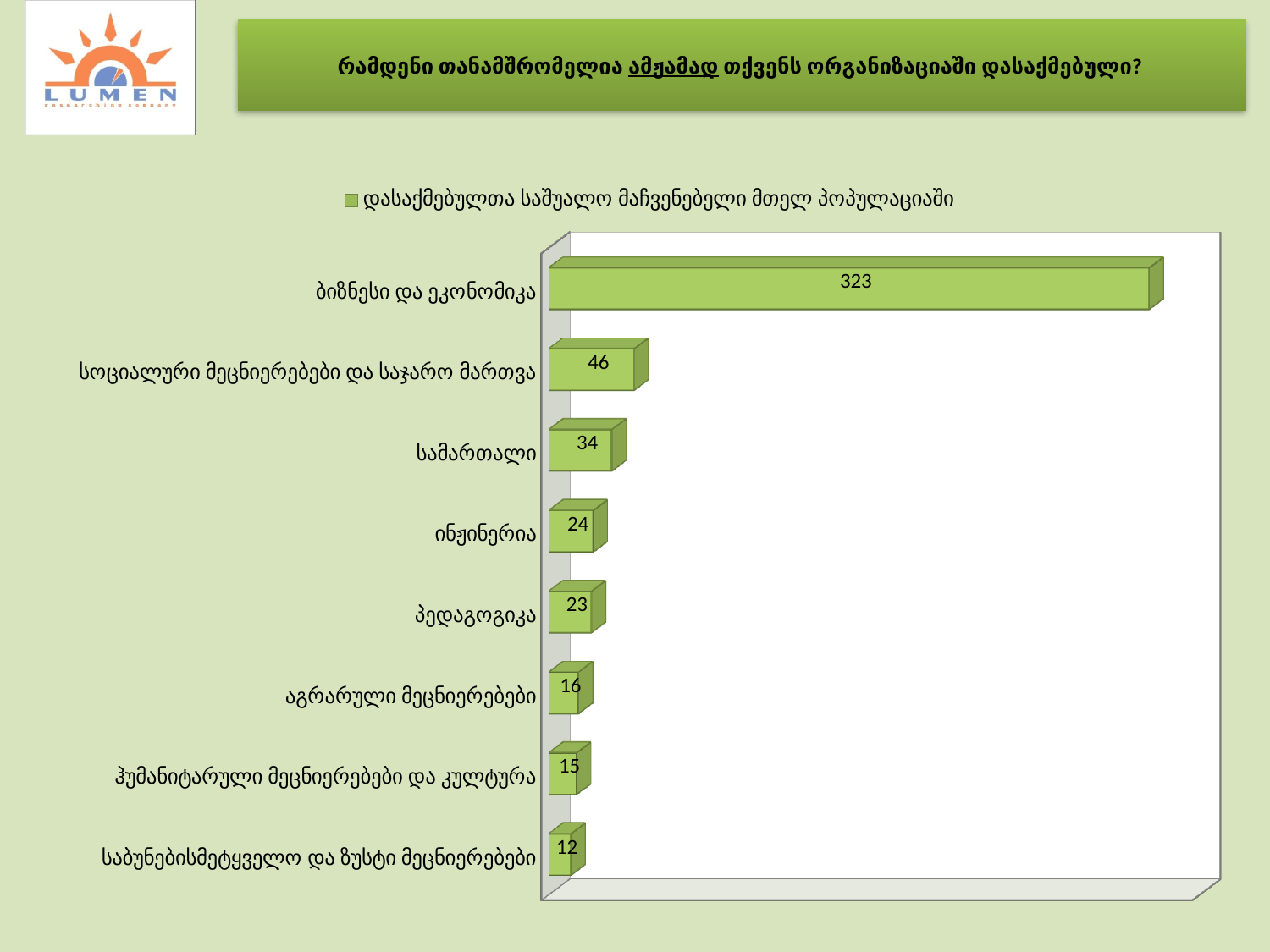
What is the value for პედაგოგიკა? 23 What is the difference between the values for სოციალური მეცნიერებები და საჯარო მართვა and სამართალი? 12 What is the value for ჰუმანიტარული მეცნიერებები და კულტურა? 15 What kind of chart is shown on the slide? bar chart Which category has the highest value? ბიზნესი და ეკონომიკა How many categories are shown in the chart? 8 What is the difference between the values for ბიზნესი და ეკონომიკა and ინჟინერია? 299 How many series does the legend list? 1 What is the value for სამართალი? 34 What is the value for ბიზნესი და ეკონომიკა? 323 Which is larger, the value for ინჟინერია or the value for აგრარული მეცნიერებები? ინჟინერია Which category has the lowest value? საბუნებისმეტყველო და ზუსტი მეცნიერებები